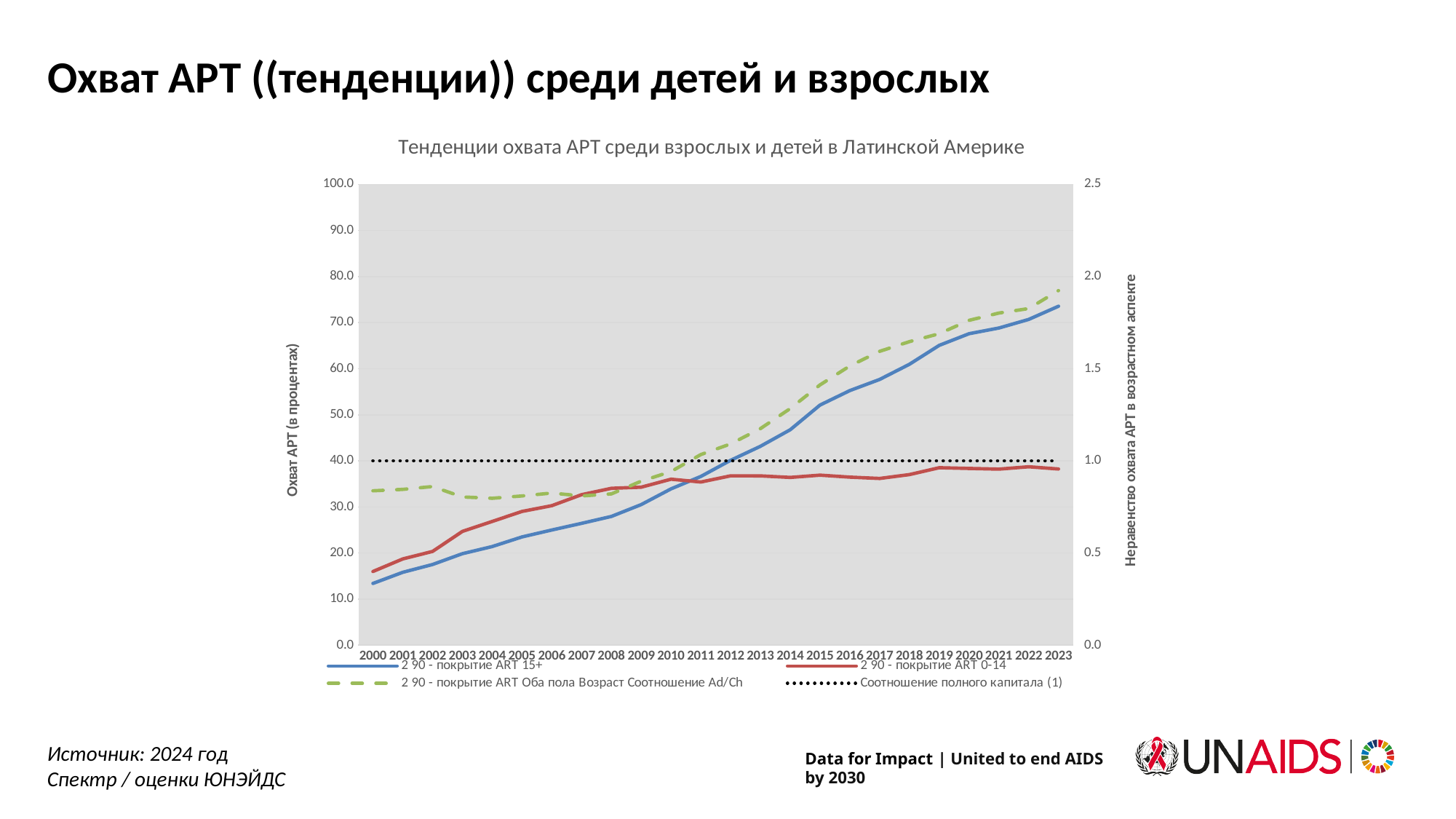
How many series does the chart legend list? 4 Does the '2 90 - покрытие ART 15+' series rise or fall from 2000 to 2023? Rise Is the value for '2 90 - покрытие ART 0-14' in 2023 greater or less than 40.0? less Is the value for '2 90 - покрытие ART 15+' in 2023 greater or less than 70.0? greater Is the value for '2 90 - покрытие ART 15+' in 2015 greater or less than 50.0? greater How many years are plotted along the x axis? 24 What is the label of the left vertical axis? Охват АРТ (в процентах) What kind of chart is shown on the slide? Line chart What is the title of the chart? Тенденции охвата АРТ среди взрослых и детей в Латинской Америке In 2005, which series is higher: '2 90 - покрытие ART 15+' or '2 90 - покрытие ART 0-14'? 2 90 - покрытие ART 0-14 In 2023, which series is higher: '2 90 - покрытие ART 15+' or '2 90 - покрытие ART 0-14'? 2 90 - покрытие ART 15+